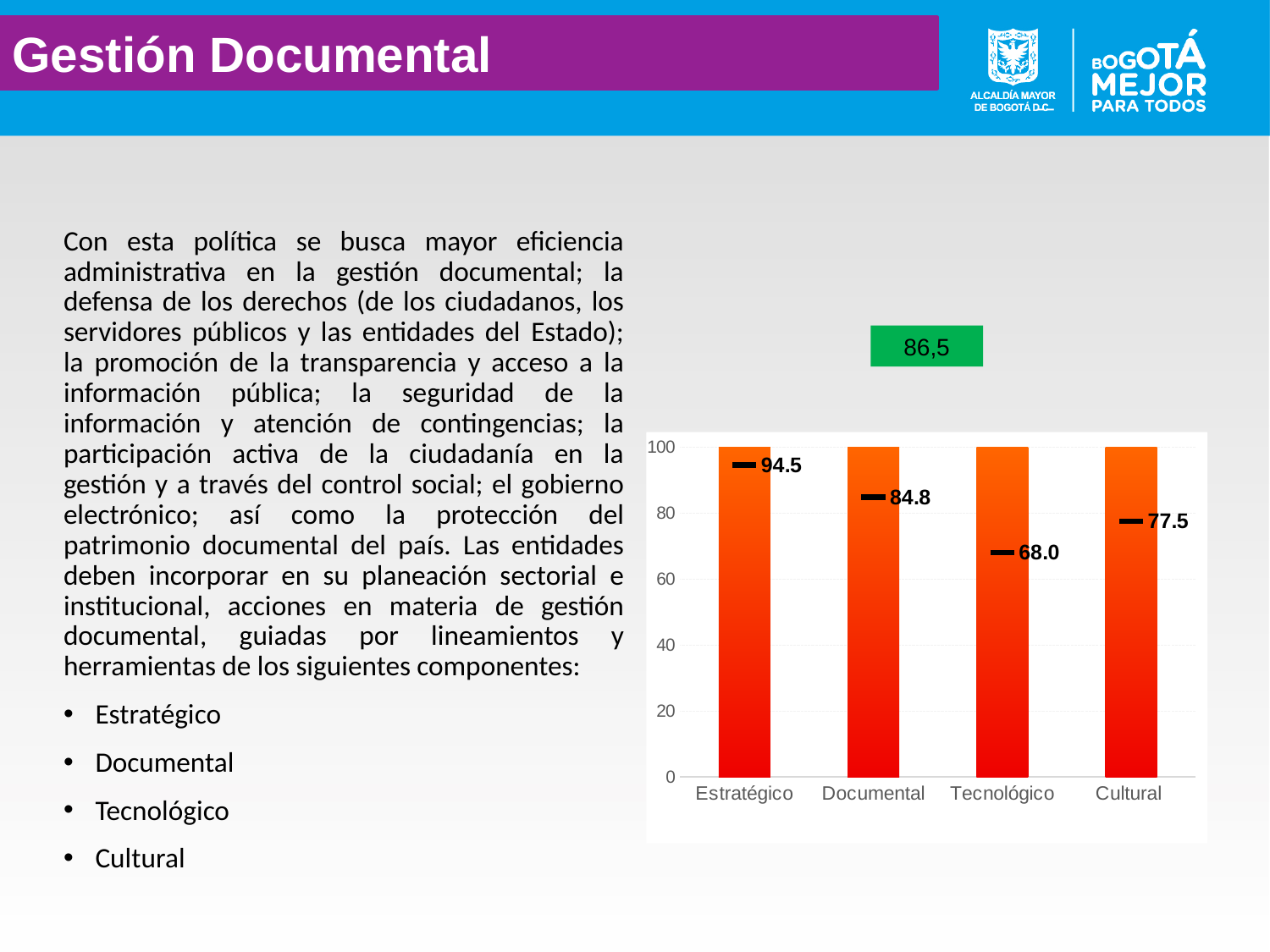
What is the difference between the labelled values for Estratégico and Documental? 9.7 What value is labelled for Cultural on the chart? 77.5 What is the difference between the labelled values for Cultural and Tecnológico? 9.5 How many categories are shown on the x axis of the chart? 4 Which category has the lowest labelled value on the chart? Tecnológico What kind of chart is shown on the slide? Bar chart What number is shown in the green box above the chart? 86,5 Which has a larger labelled value, Documental or Cultural? Documental What value is labelled for Tecnológico on the chart? 68.0 Which category has the highest labelled value on the chart? Estratégico What value is labelled for Documental on the chart? 84.8 What value is labelled for Estratégico on the chart? 94.5